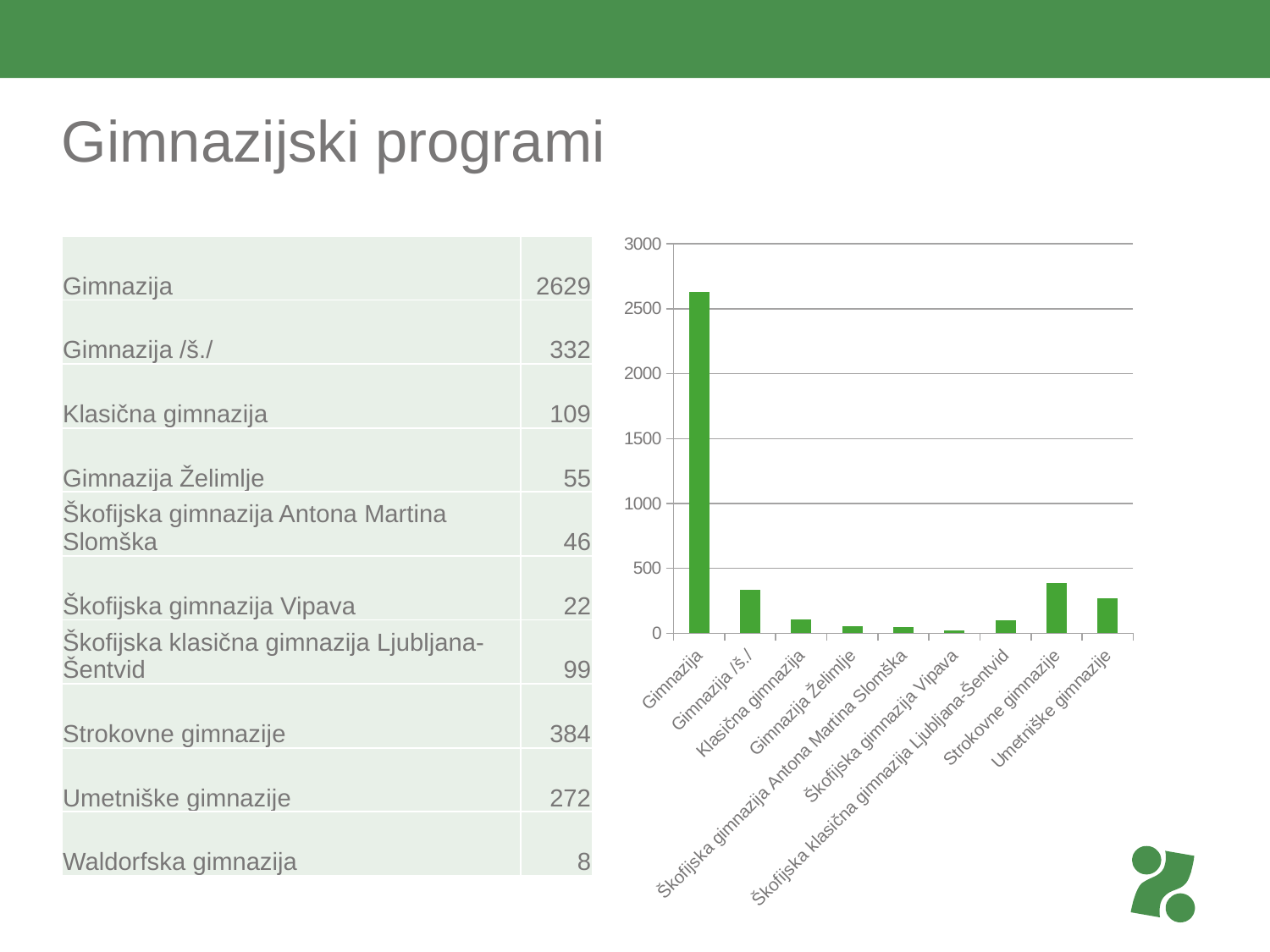
What is the title of the slide containing the chart? Gimnazijski programi What kind of chart is shown on the slide? bar chart What is the value for Gimnazija? 2629 Is the value for Strokovne gimnazije greater or less than 500? less What is the value for Škofijska gimnazija Antona Martina Slomška? 46 What is the difference between the values for Gimnazija /š./ and Klasična gimnazija? 223 What is the difference between the values for Strokovne gimnazije and Umetniške gimnazije? 112 What is the value for Strokovne gimnazije? 384 Which is larger, the value for Gimnazija /š./ or the value for Umetniške gimnazije? Gimnazija /š./ Which is larger, the value for Strokovne gimnazije or the value for Umetniške gimnazije? Strokovne gimnazije Is the value for Gimnazija greater or less than 2500? greater Which category has the highest bar in the chart? Gimnazija